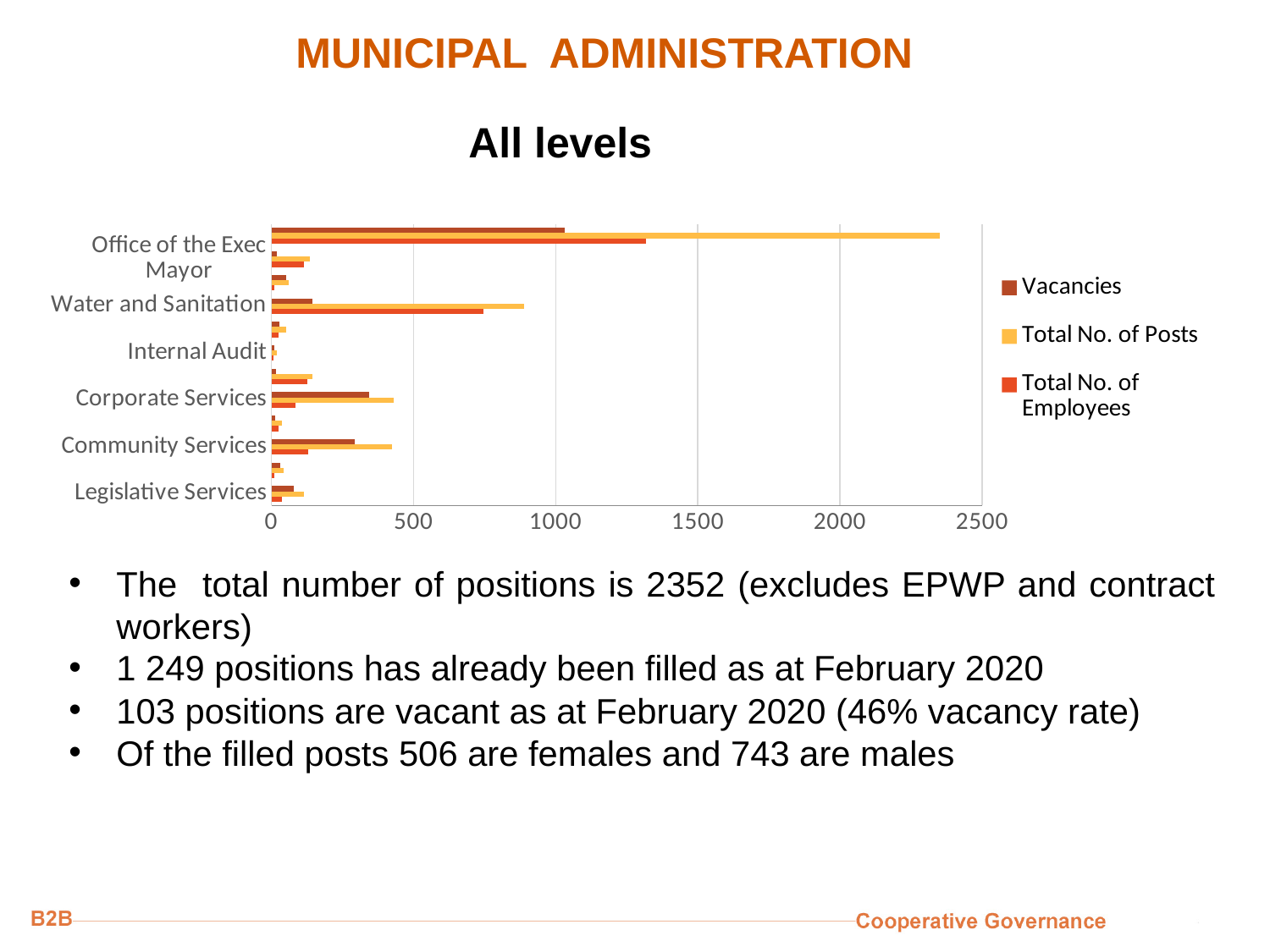
Is the Vacancies value for Water and Sanitation greater or less than 500? less Among the labeled categories, which has the lowest Total No. of Posts value? Internal Audit What kind of chart is shown on the slide? bar chart Is the Total No. of Posts value for Corporate Services greater or less than 500? less How many series does the chart legend list? 3 Is the Total No. of Posts value for Legislative Services greater or less than 500? less Which has the larger Total No. of Posts value, Water and Sanitation or Corporate Services? Water and Sanitation What are the three series named in the chart legend? Vacancies, Total No. of Posts, Total No. of Employees Which has the larger Total No. of Employees value, Water and Sanitation or Legislative Services? Water and Sanitation What is the title shown above the chart? All levels